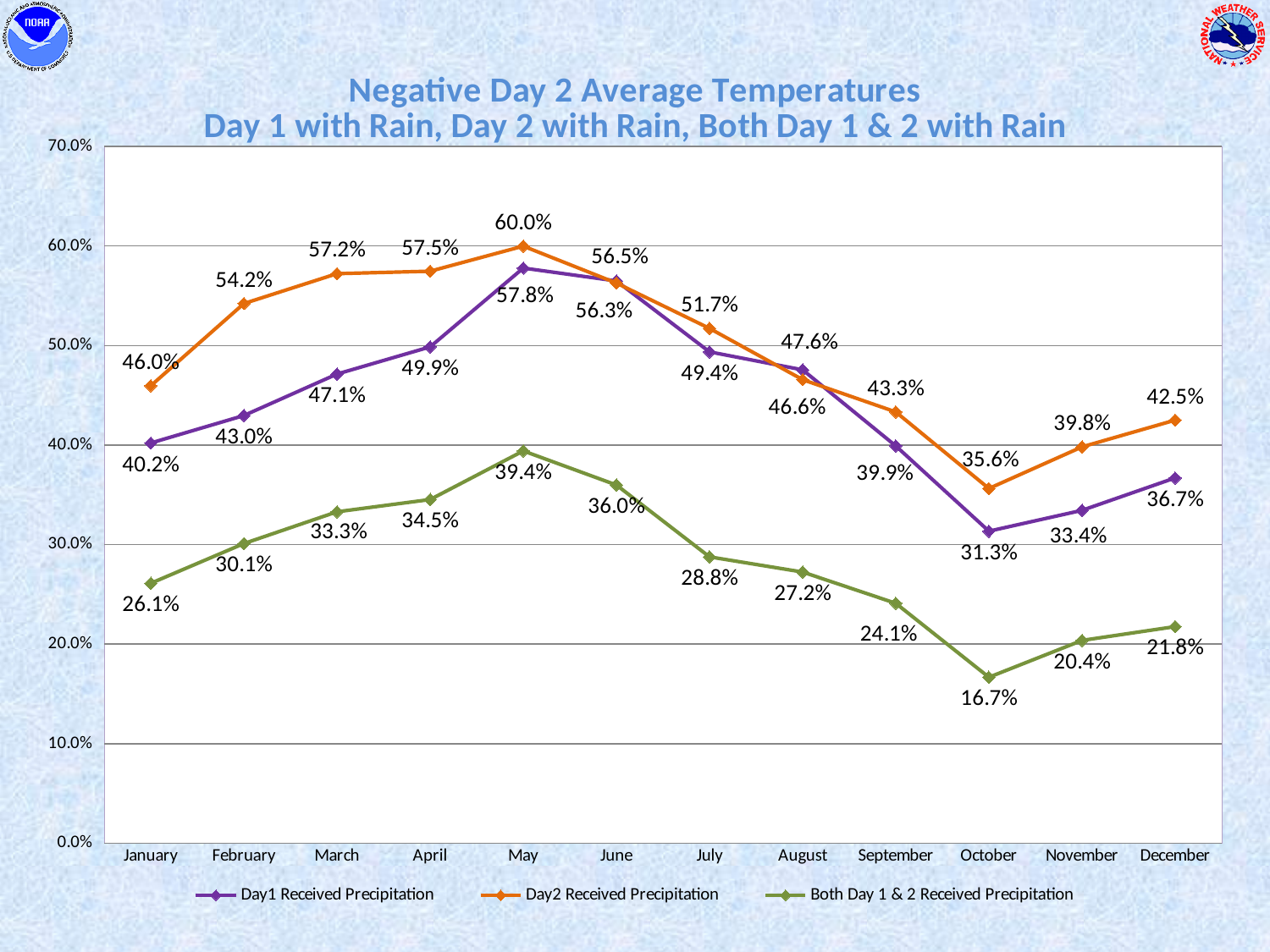
How many series does the legend list? 3 What type of chart is shown on the slide? line chart Which is larger in December: Day2 Received Precipitation or Day1 Received Precipitation? Day2 Received Precipitation How many months are plotted along the x axis? 12 What is the difference between Day2 Received Precipitation and Day1 Received Precipitation in February? 11.2% What is the value for Day1 Received Precipitation in January? 40.2% What is the value for Both Day 1 & 2 Received Precipitation in October? 16.7% In which month is the Day1 Received Precipitation series highest? May In which month is the Both Day 1 & 2 Received Precipitation series lowest? October Which colour is used for the Day2 Received Precipitation line? orange Does the Both Day 1 & 2 Received Precipitation series rise or fall from May to October? fall What is the value for Day2 Received Precipitation in May? 60.0%